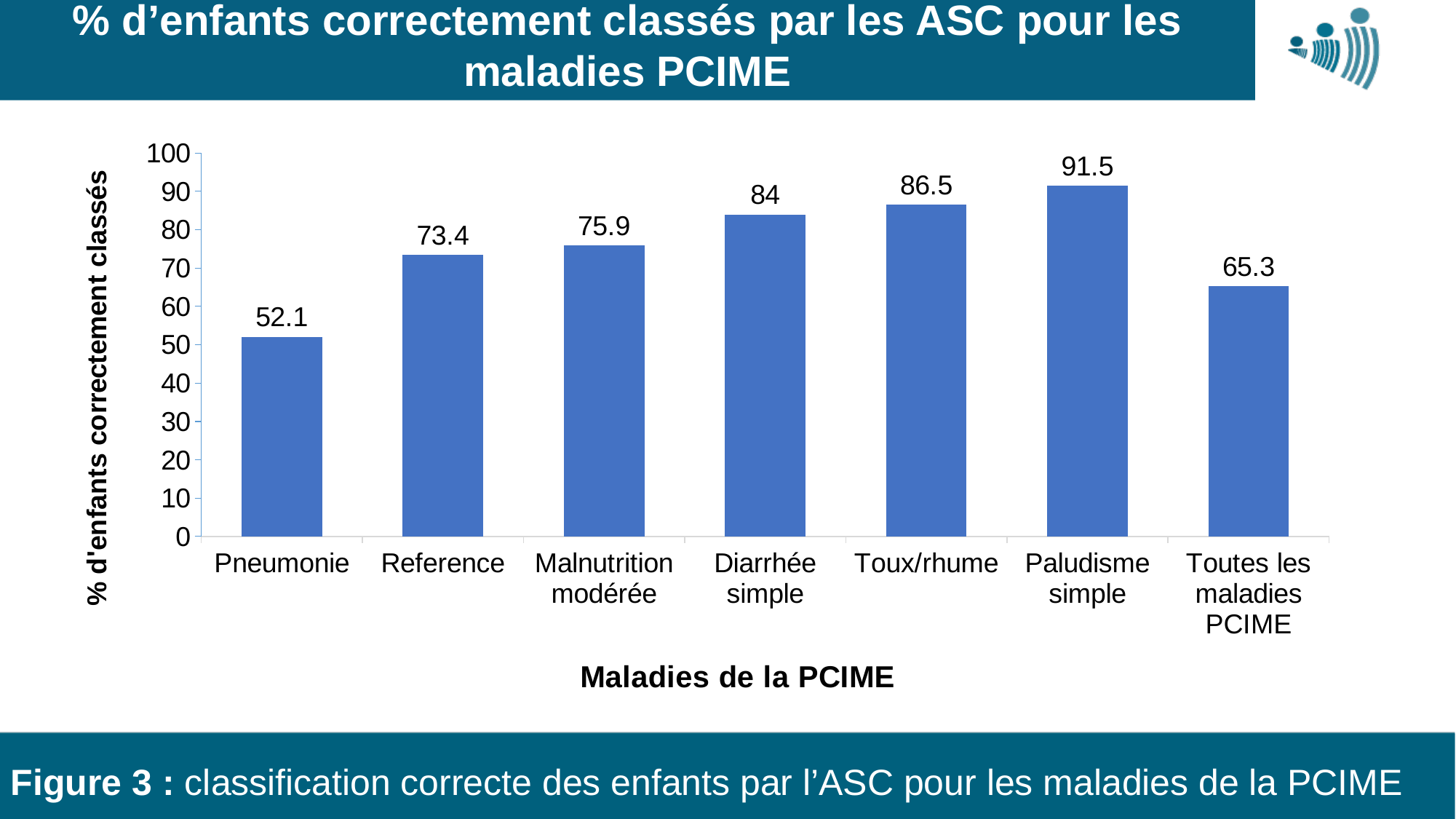
What is the value for Paludisme simple? 91.5 What is the difference between the values for Paludisme simple and Pneumonie? 39.4 Which category has the lowest value? Pneumonie What is the value for Pneumonie? 52.1 How many categories are shown on the x axis? 7 What kind of chart is shown on the slide? bar chart Is the value for Malnutrition modérée greater or less than 70? greater Which category has the highest value? Paludisme simple What is the value for Toutes les maladies PCIME? 65.3 Which is larger, the value for Diarrhée simple or the value for Reference? Diarrhée simple What is the difference between the values for Toux/rhume and Diarrhée simple? 2.5 What is the x-axis title of the chart? Maladies de la PCIME